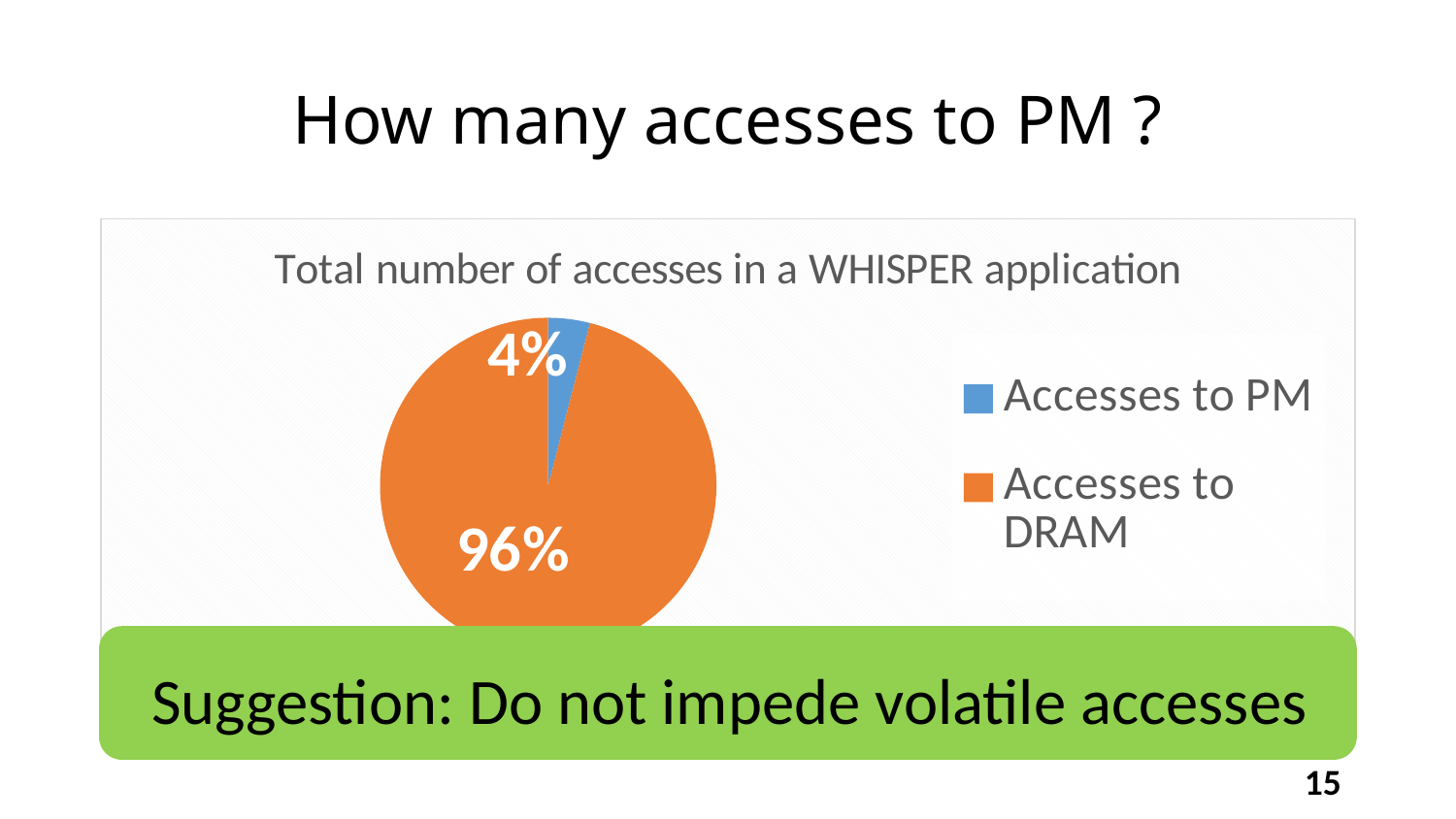
Which category has the largest slice of the pie? Accesses to DRAM What kind of chart is shown on the slide? pie chart What is the difference in percentage points between Accesses to DRAM and Accesses to PM? 92 What colour is the Accesses to PM slice? blue What share of the pie is Accesses to PM? 4% Which is larger, Accesses to PM or Accesses to DRAM? Accesses to DRAM What share of the pie is Accesses to DRAM? 96% Which category has the smallest slice of the pie? Accesses to PM What is the title of the chart? Total number of accesses in a WHISPER application How many entries does the legend list? 2 How many categories does the pie chart have? 2